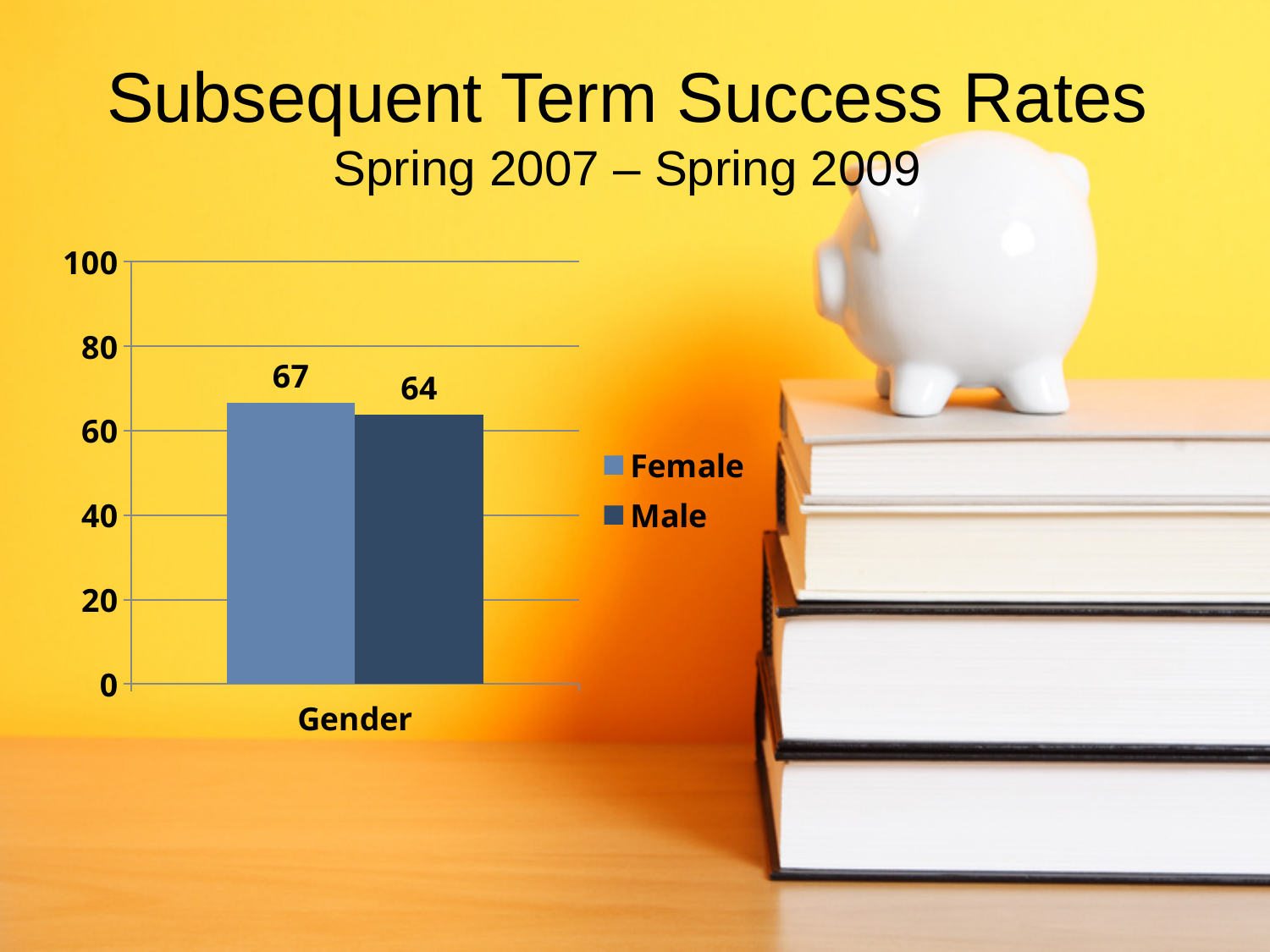
Which series has the lower value? Male Is the value for Female greater or less than 80? less What is the value for Female? 67 Is the value for Male greater or less than 60? greater What kind of chart is shown on the slide? bar chart What is the value for Male? 64 Which series has the higher value, Female or Male? Female How many series does the legend list? 2 What is the label on the x axis of the chart? Gender What is the difference between the Female and Male values? 3 Is the value for Male larger or smaller than the value for Female? smaller What is the maximum value shown on the y axis? 100